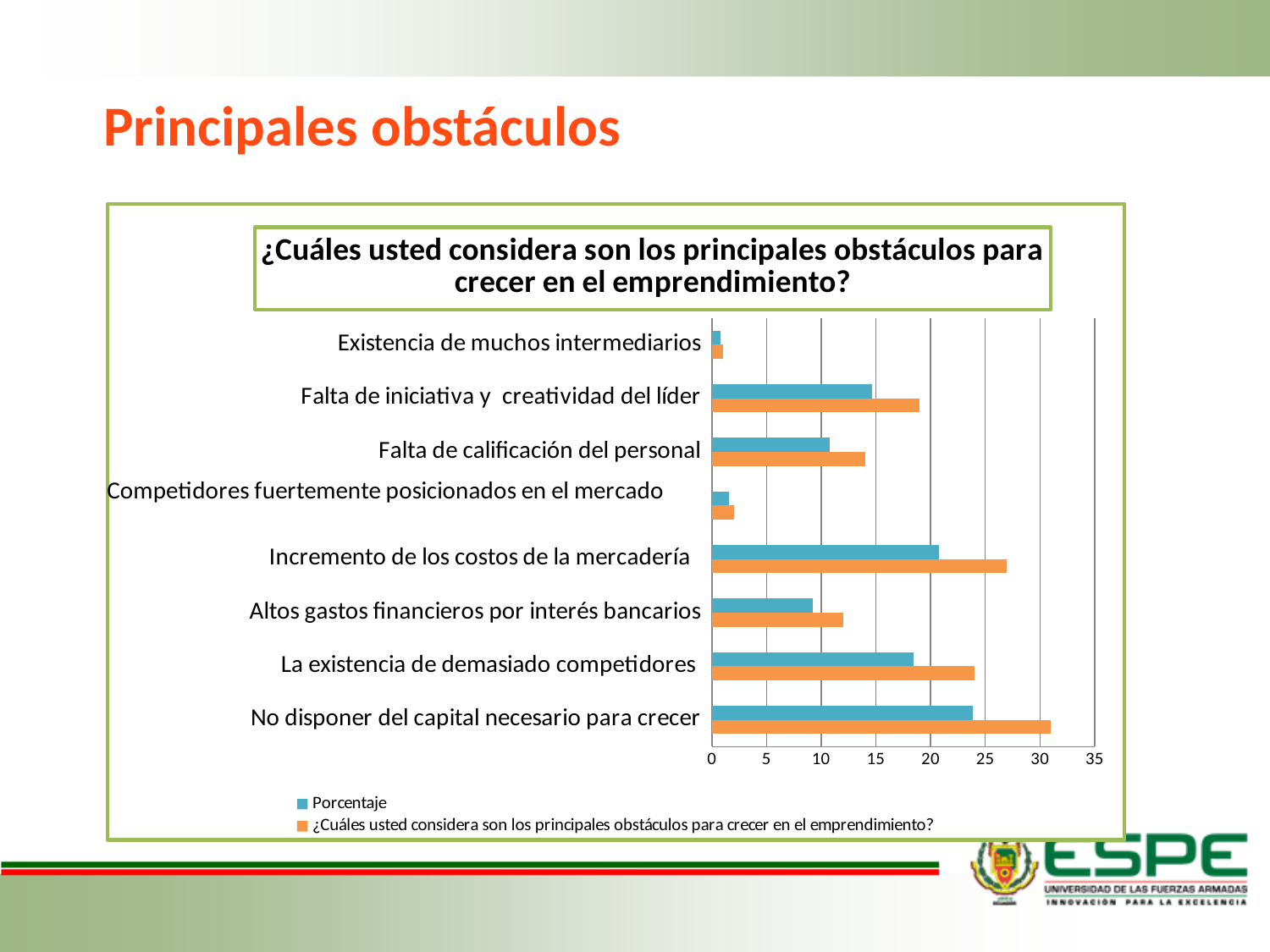
Which obstacle has the highest value in the Porcentaje series? No disponer del capital necesario para crecer In the orange series, which is larger: 'Falta de iniciativa y creatividad del líder' or 'Falta de calificación del personal'? Falta de iniciativa y creatividad del líder What kind of chart is shown on the slide? bar chart How many series does the legend list? 2 Is the orange-series value for 'No disponer del capital necesario para crecer' greater or less than 30? greater What is the title of the chart? ¿Cuáles usted considera son los principales obstáculos para crecer en el emprendimiento? Is the Porcentaje value for 'La existencia de demasiado competidores' greater or less than 20? less How many categories (obstacles) are listed on the chart? 8 Is the orange-series value for 'Altos gastos financieros por interés bancarios' greater or less than 10? greater Which obstacle has the lowest value in the orange series? Existencia de muchos intermediarios In the orange series, which is larger: 'Incremento de los costos de la mercadería' or 'La existencia de demasiado competidores'? Incremento de los costos de la mercadería